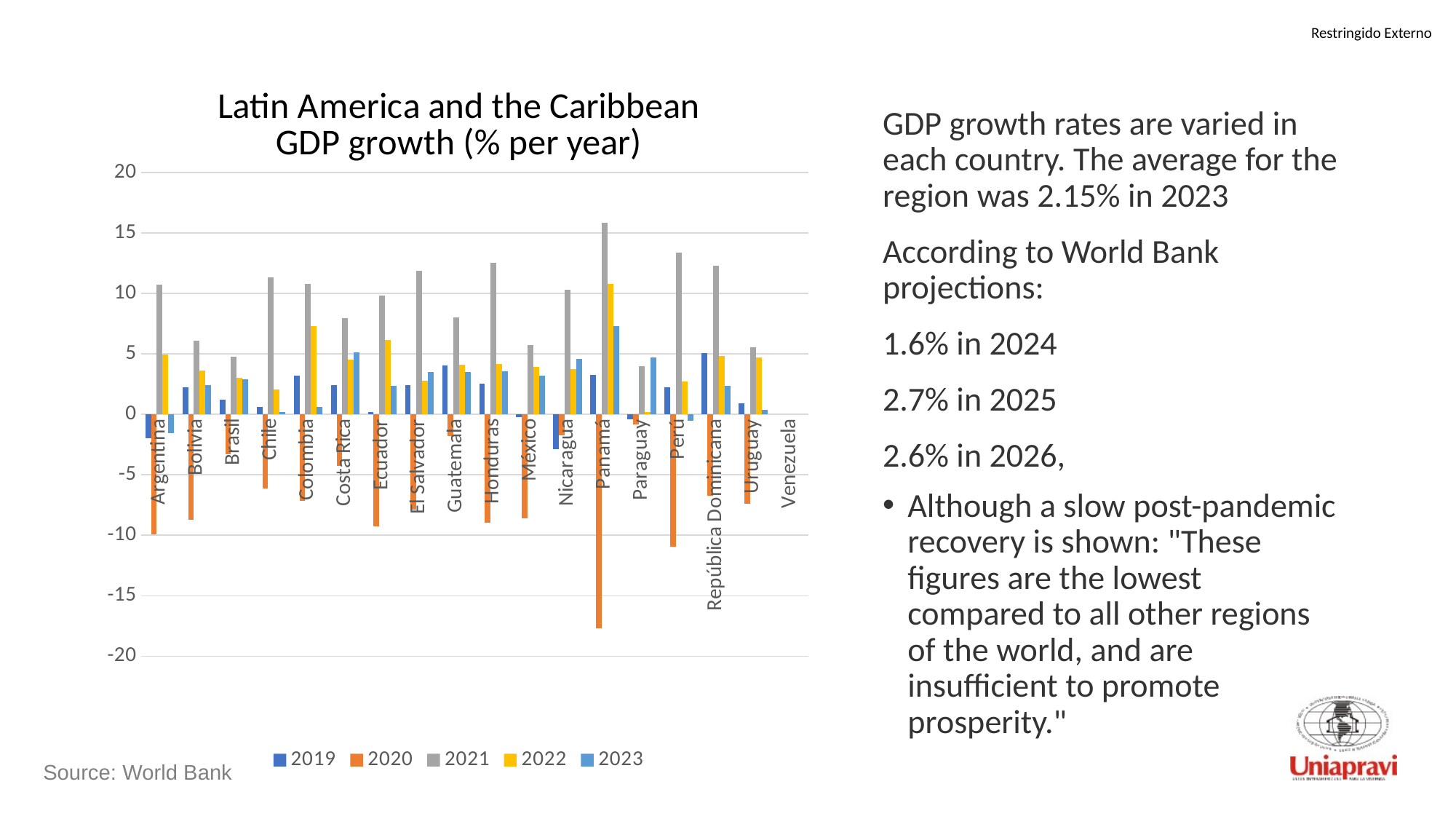
Which country has the highest 2021 GDP growth bar? Panamá Which country has the highest 2022 GDP growth bar? Panamá Which colour represents the 2020 series in the legend? orange Is the 2020 value for Panamá greater or less than -15? less How many countries are shown on the x axis of the chart? 18 Which country has the lowest 2020 GDP growth bar? Panamá Is the 2021 value for Paraguay greater or less than 5? less Is the 2021 value for Panamá greater or less than 15? greater How many series does the legend list? 5 Which is larger, the 2021 value for Panamá or the 2021 value for Perú? Panamá What kind of chart is shown on the slide? bar chart